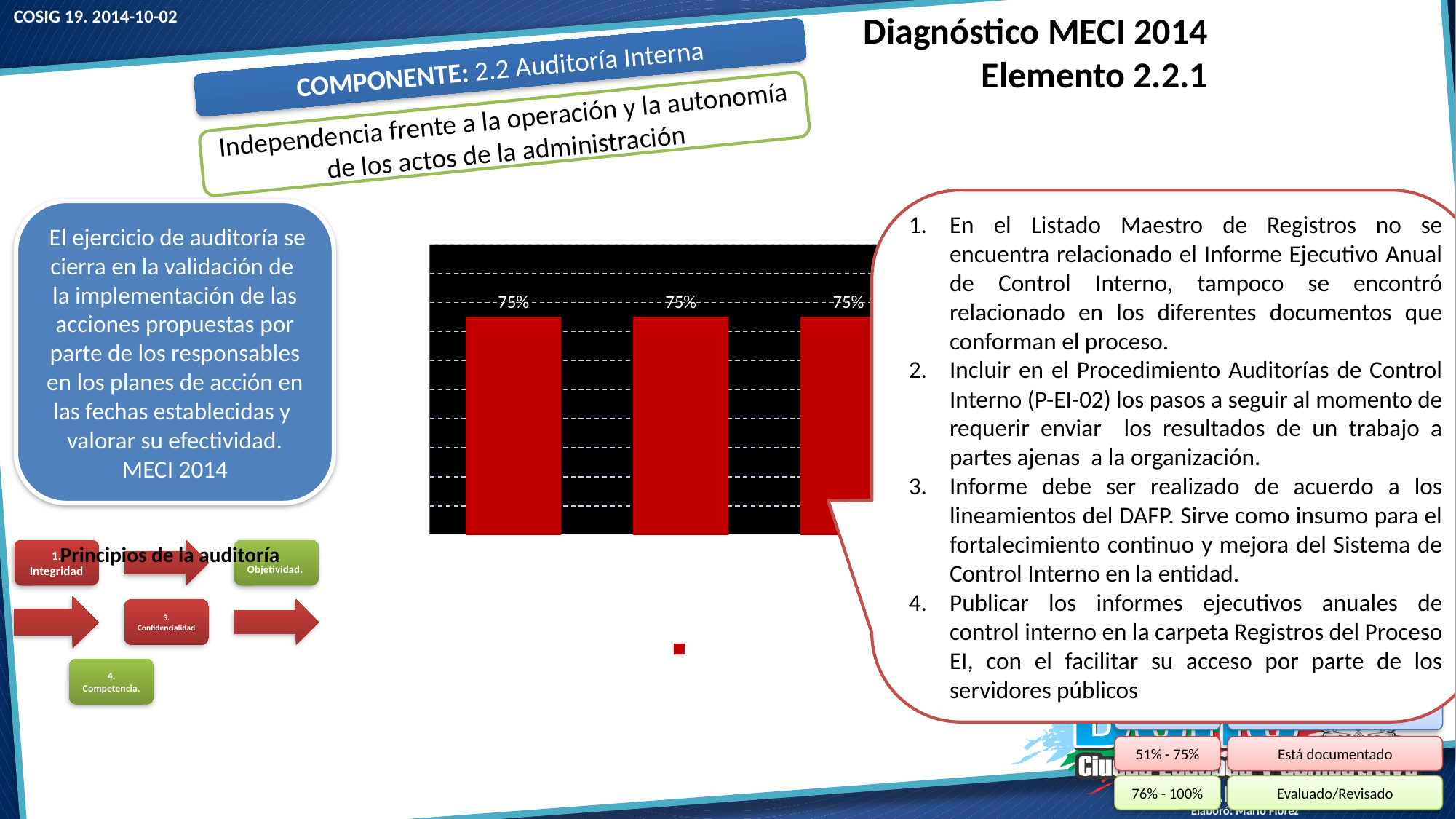
What colour is the plot area background of the chart? black What value is printed above the leftmost bar of the chart? 75% What kind of chart is shown in the centre of the slide? bar chart Do the bar values rise, fall, or stay the same from left to right across the chart? stay the same Is the value of the leftmost bar greater or less than 100%? less What value is printed above the middle bar of the chart? 75% Is the value of the middle bar greater or less than 50%? greater What colour are the bars in the chart? red What is the difference between the value of the leftmost bar and the value of the rightmost bar? 0% What value is printed above the rightmost bar of the chart? 75%